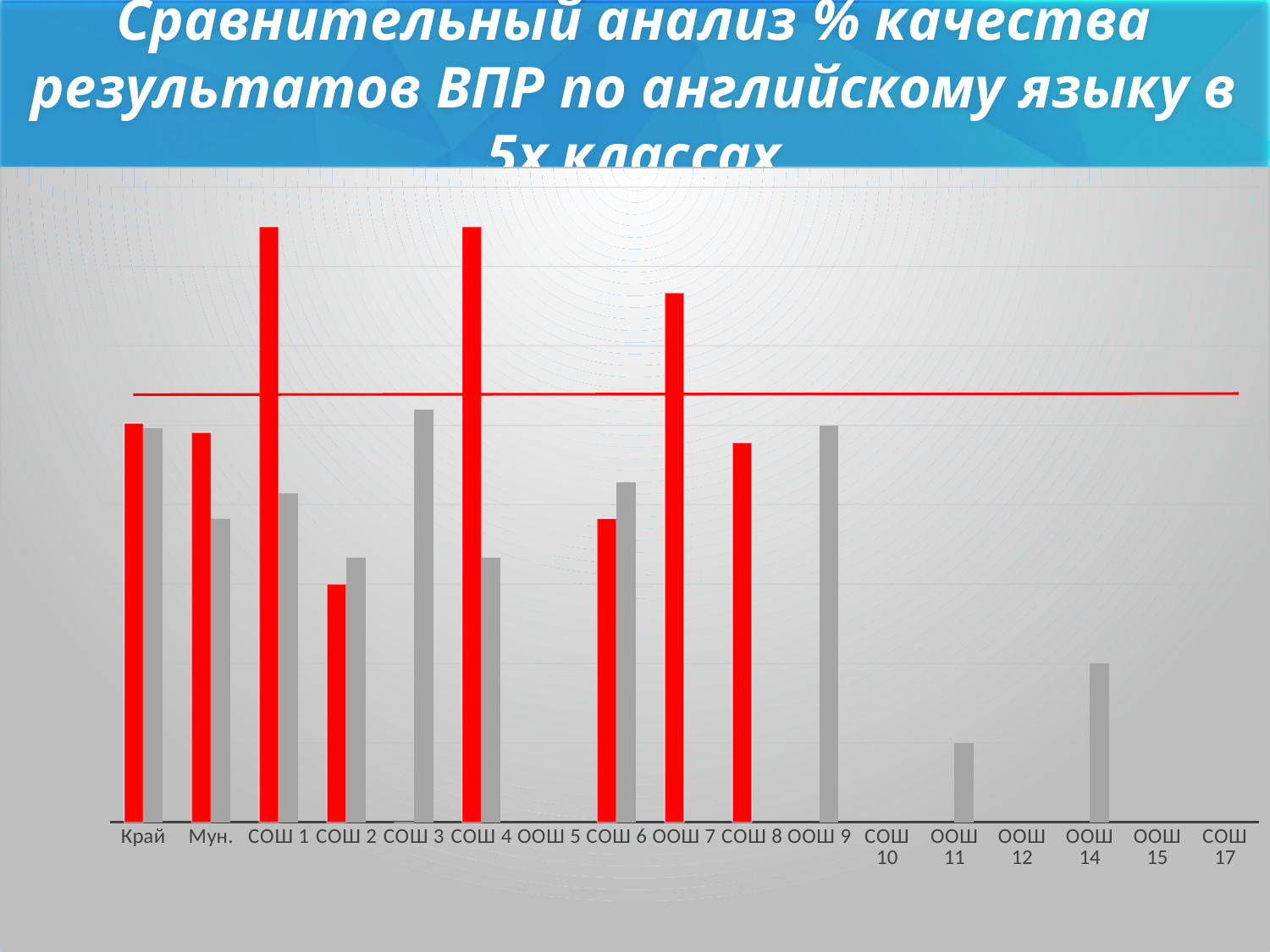
Which is larger, the gray bar for ООШ 14 or the gray bar for ООШ 11? ООШ 14 For Мун., which bar is taller, the red one or the gray one? the red one How many categories are listed along the x axis of the chart? 17 What two colours are used for the bars in the chart? red and gray For СОШ 6, which bar is taller, the red one or the gray one? the gray one What kind of chart is shown on the slide? bar chart What subject is named in the slide title? английский язык Which category has the lowest gray bar? ООШ 11 Which category has the lowest red bar? СОШ 2 How many categories on the x axis have no bars at all? 5